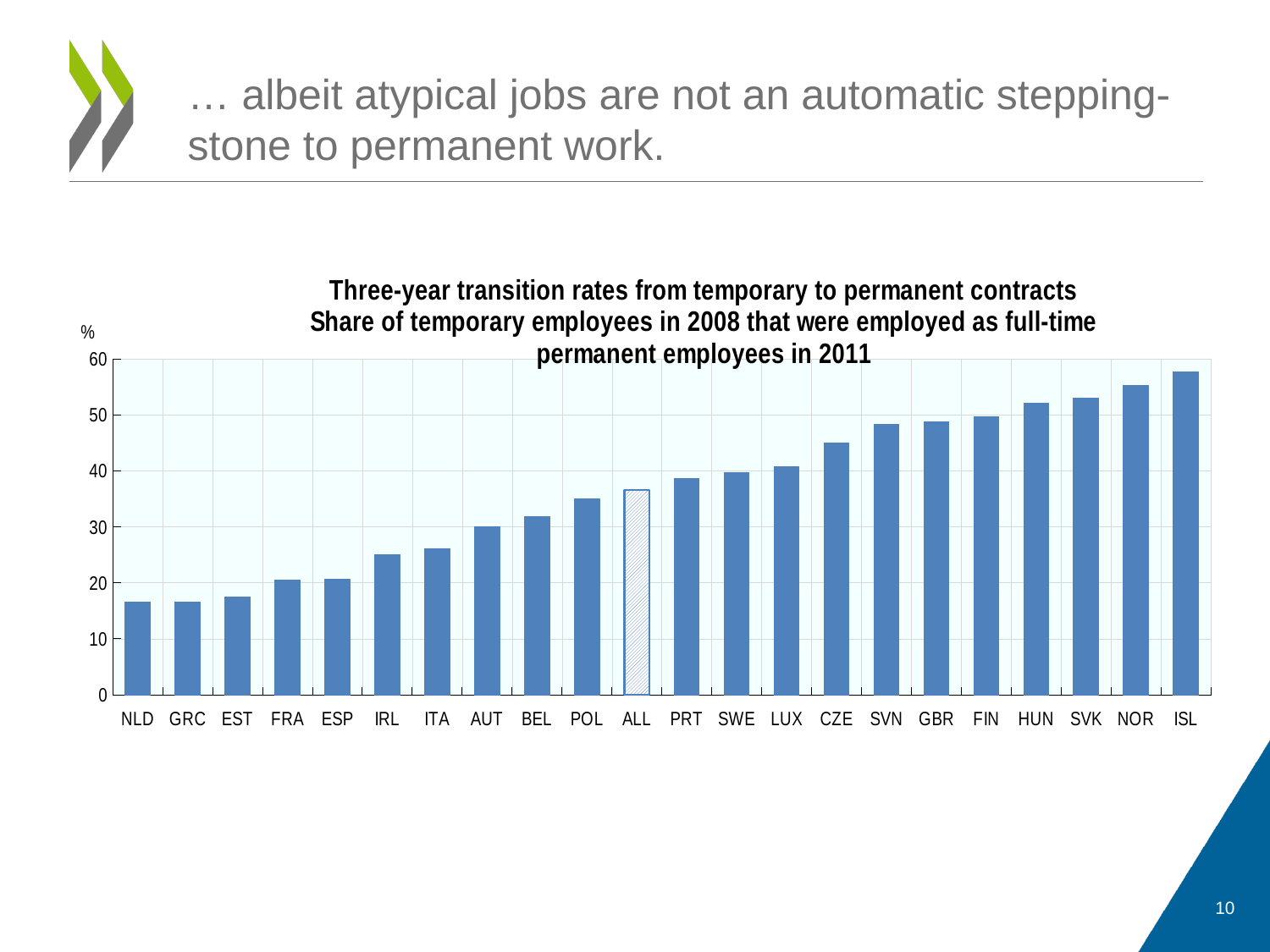
What kind of chart is shown on the slide? bar chart Is the value for ISL greater or less than 50? greater Is the value for CZE greater or less than 40? greater Which has a higher transition rate, CZE or POL? CZE Do the values generally rise or fall moving from left to right along the x axis? rise Which bar is drawn with a hatched pattern instead of solid fill? ALL Is the value for IRL greater or less than 20? greater How many countries/categories are shown on the x axis of the chart? 22 Which has a higher transition rate, ITA or PRT? PRT Which category has the highest three-year transition rate? ISL